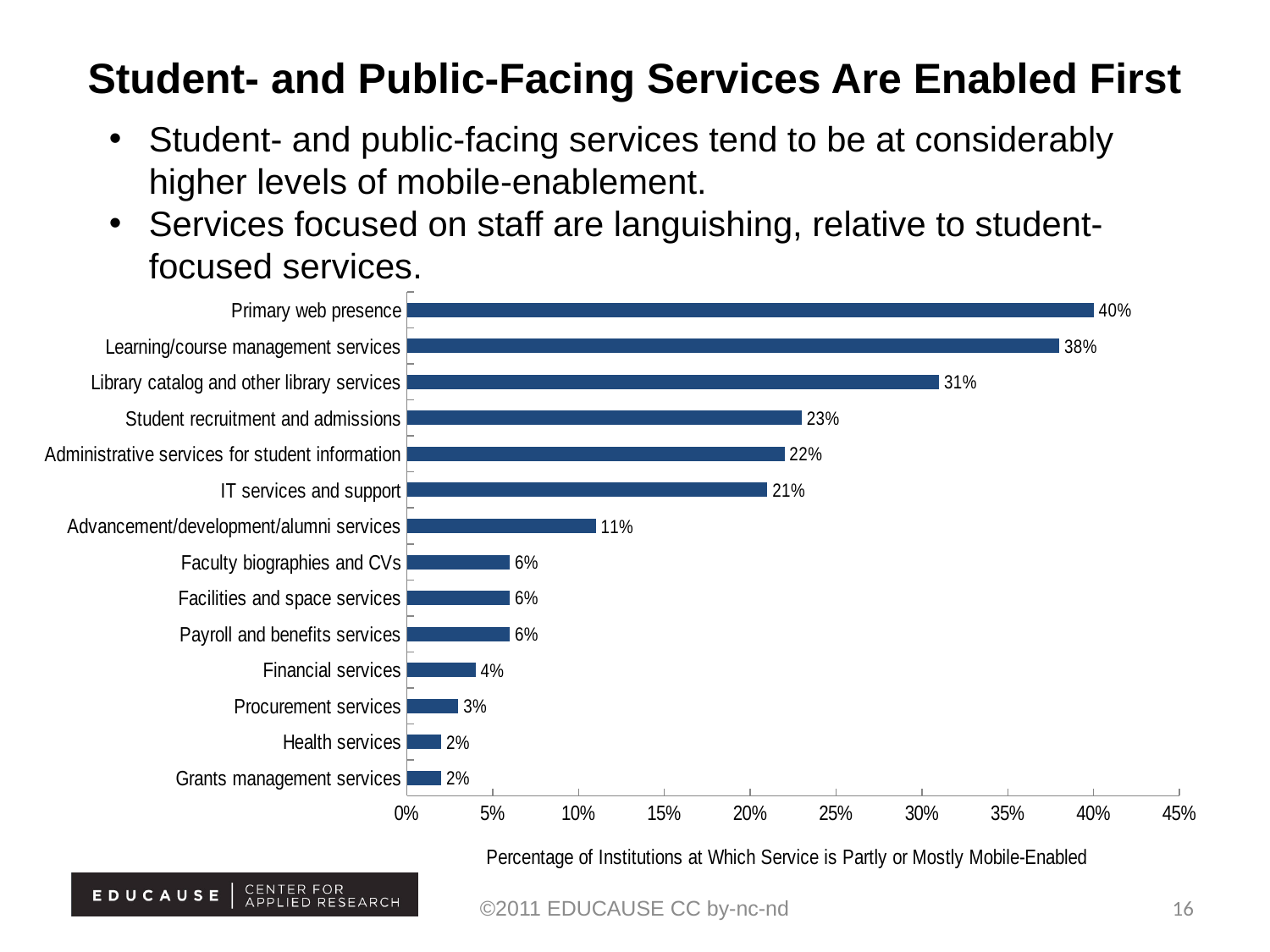
What is the value for Advancement/development/alumni services? 11% What is the difference between the values for Primary web presence and Grants management services? 38% What is the label of the horizontal axis of the chart? Percentage of Institutions at Which Service is Partly or Mostly Mobile-Enabled What is the value for Procurement services? 3% What is the highest value shown on the horizontal axis? 45% Which service has the highest percentage of institutions at which it is partly or mostly mobile-enabled? Primary web presence What is the difference between the values for Library catalog and other library services and Student recruitment and admissions? 8% What kind of chart is shown on the slide? Bar chart How many services are listed in the chart? 14 What percentage of institutions have their primary web presence partly or mostly mobile-enabled? 40% Which is larger, the value for IT services and support or the value for Faculty biographies and CVs? IT services and support What is the value for Learning/course management services? 38%